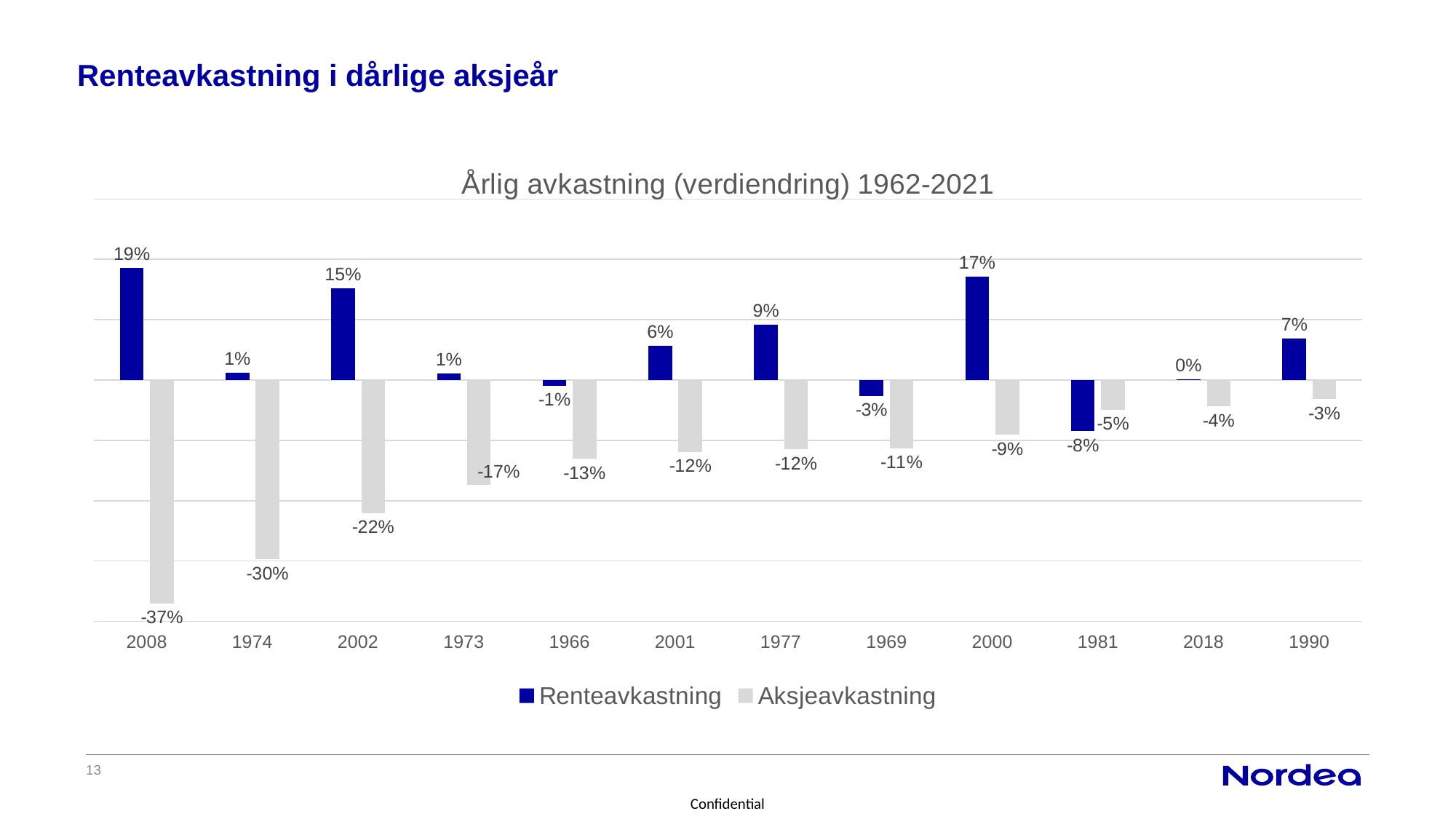
What is the Renteavkastning value for 2008? 19% Which year has the lowest Aksjeavkastning value? 2008 What is the difference between the Renteavkastning and Aksjeavkastning values for 2002? 37 percentage points What kind of chart is shown on the slide? Bar chart Which year has the highest Renteavkastning value? 2008 Which year has the lowest Renteavkastning value? 1981 How many years are shown on the x axis? 12 What is the title of the chart? Årlig avkastning (verdiendring) 1962-2021 What is the Renteavkastning value for 2018? 0% Which is larger, the Renteavkastning value for 2000 or the Renteavkastning value for 1977? 2000 How many series does the legend list? 2 What is the Aksjeavkastning value for 1974? -30%